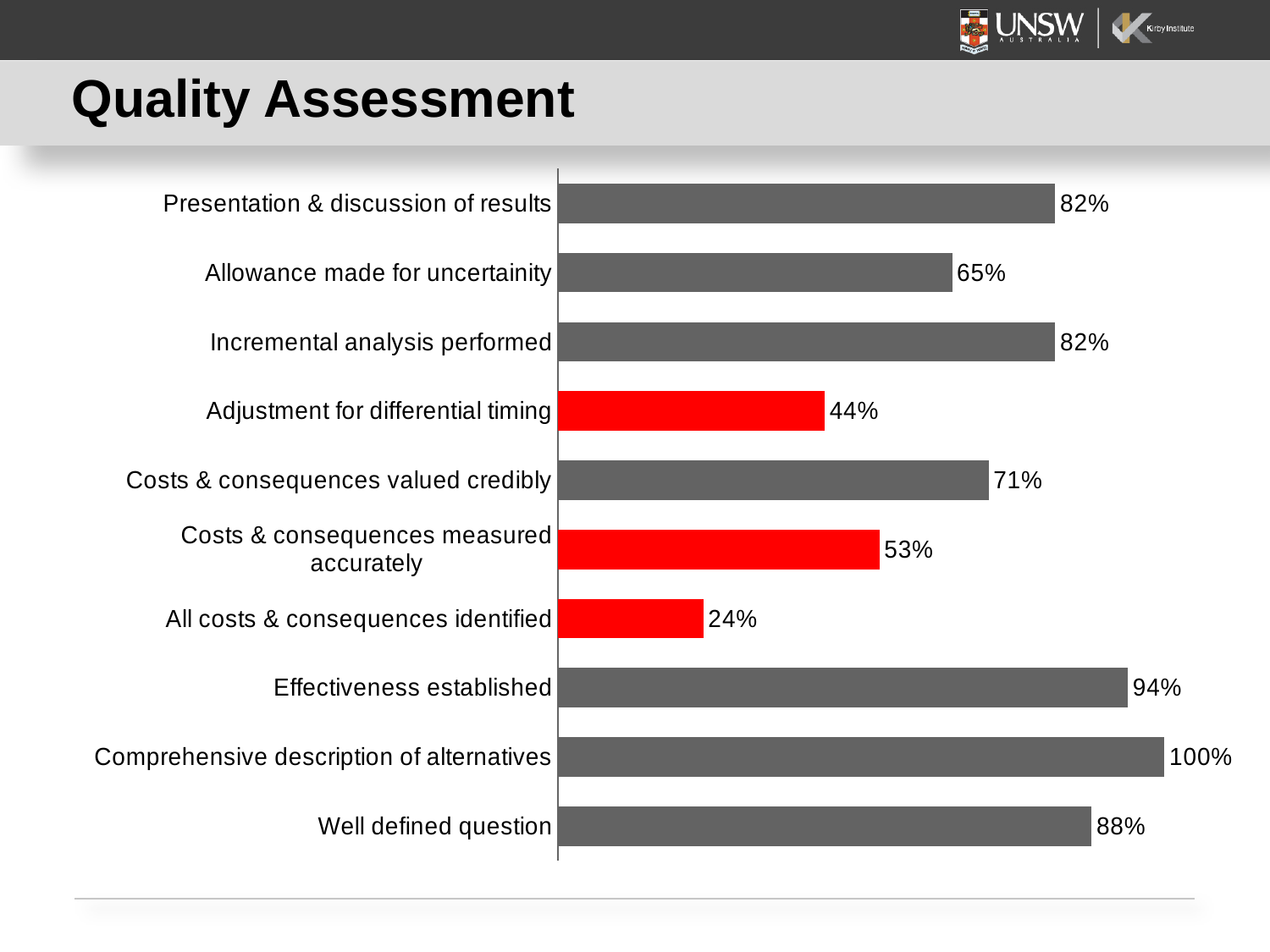
Which category has the highest value? Comprehensive description of alternatives What is the value for Effectiveness established? 94% What kind of chart is shown on the slide? Bar chart Which category has the lowest value? All costs & consequences identified How many bars are coloured red? 3 How many categories are shown in the chart? 10 Which is larger, the value for Costs & consequences valued credibly or the value for Costs & consequences measured accurately? Costs & consequences valued credibly What is the title of the slide containing the chart? Quality Assessment What is the value for Adjustment for differential timing? 44% What is the difference between the values for Effectiveness established and All costs & consequences identified? 70% What is the difference between the values for Well defined question and Allowance made for uncertainity? 23% What is the value for All costs & consequences identified? 24%